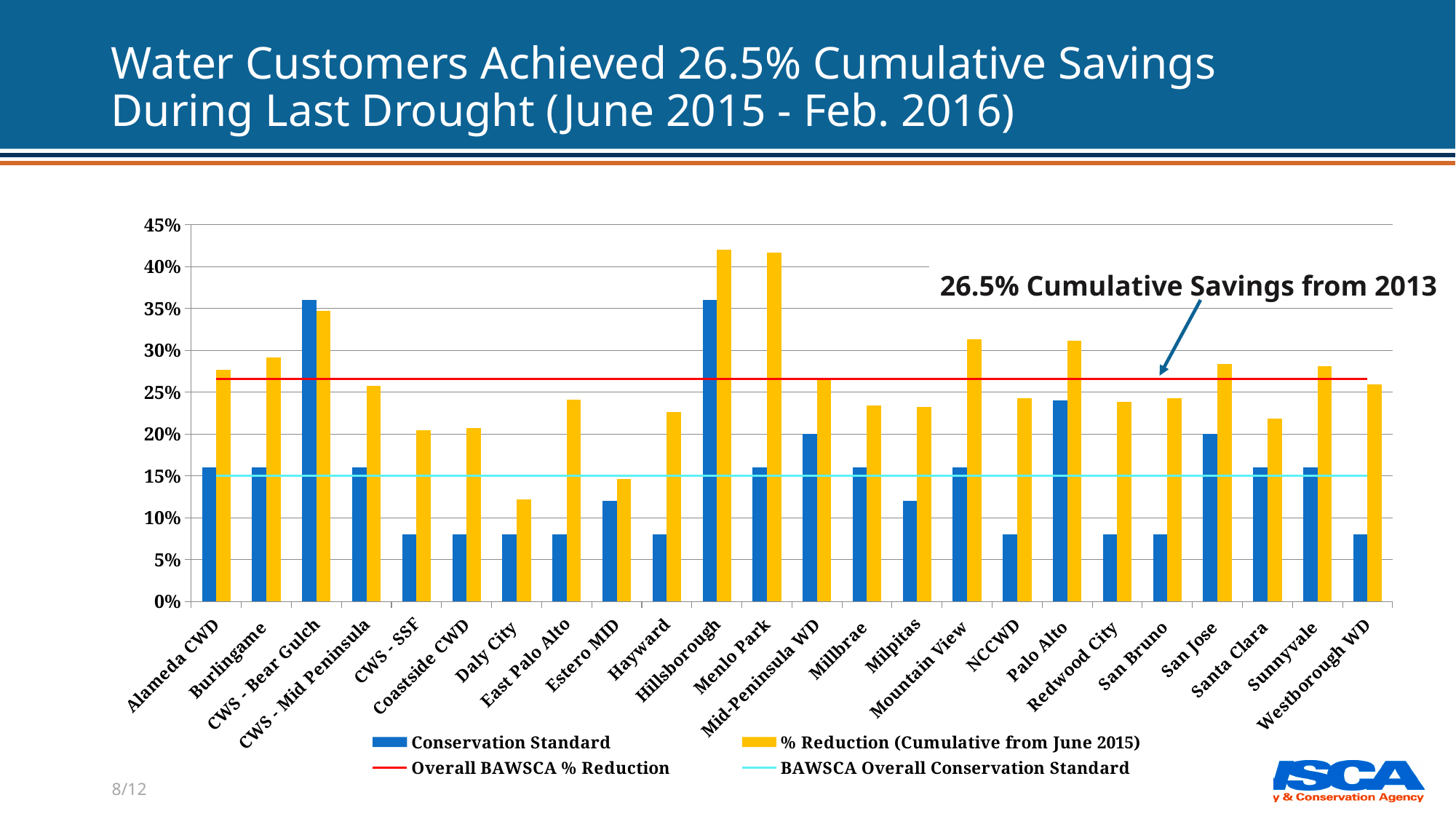
Is the Conservation Standard value for CWS - Bear Gulch greater or less than 35%? greater Which has the larger Conservation Standard bar, Palo Alto or San Jose? Palo Alto What colour are the Conservation Standard bars in the chart? blue How many water agencies (categories) are shown on the x axis of the chart? 24 What kind of chart is shown on the slide? combination bar and line chart What cumulative savings value does the red Overall BAWSCA % Reduction line represent, according to the annotation on the chart? 26.5% Is the % Reduction (Cumulative from June 2015) value for Hillsborough greater or less than 40%? greater Which has the larger % Reduction (Cumulative from June 2015) bar, Burlingame or Alameda CWD? Burlingame Is the % Reduction (Cumulative from June 2015) value for Daly City greater or less than 15%? less Which agency has the lowest % Reduction (Cumulative from June 2015) bar? Daly City How many entries does the chart's legend list? 4